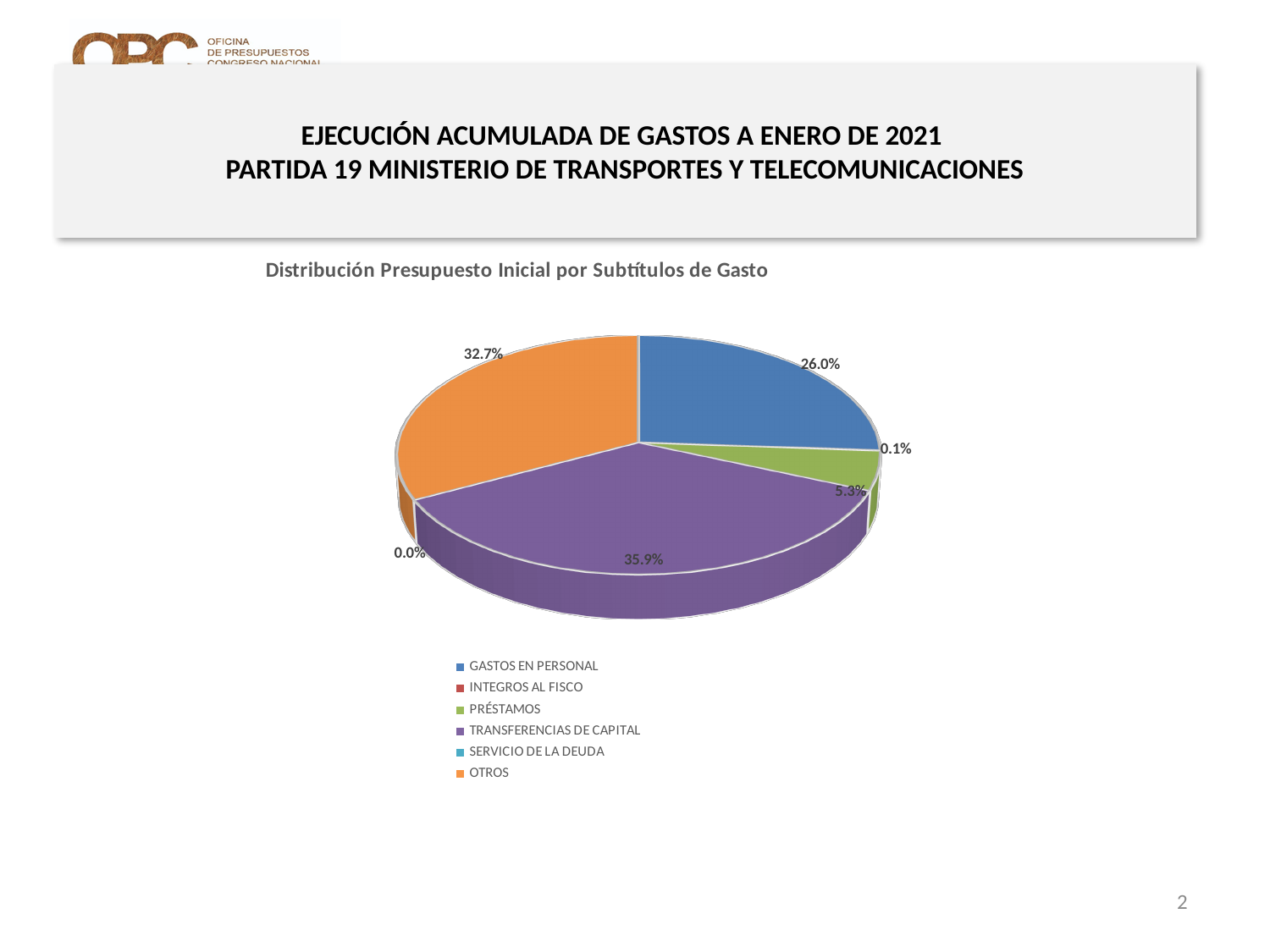
What share of the pie does TRANSFERENCIAS DE CAPITAL represent? 35.9% How many categories does the legend list? 6 Which category has the smallest share of the pie? SERVICIO DE LA DEUDA What share of the pie does INTEGROS AL FISCO represent? 0.1% What share of the pie does GASTOS EN PERSONAL represent? 26.0% What is the title of the chart? Distribución Presupuesto Inicial por Subtítulos de Gasto What is the difference between the shares of TRANSFERENCIAS DE CAPITAL and OTROS? 3.2% Which category has the largest share of the pie? TRANSFERENCIAS DE CAPITAL What kind of chart is shown on the slide? Pie chart Which is larger, the share for OTROS or the share for GASTOS EN PERSONAL? OTROS